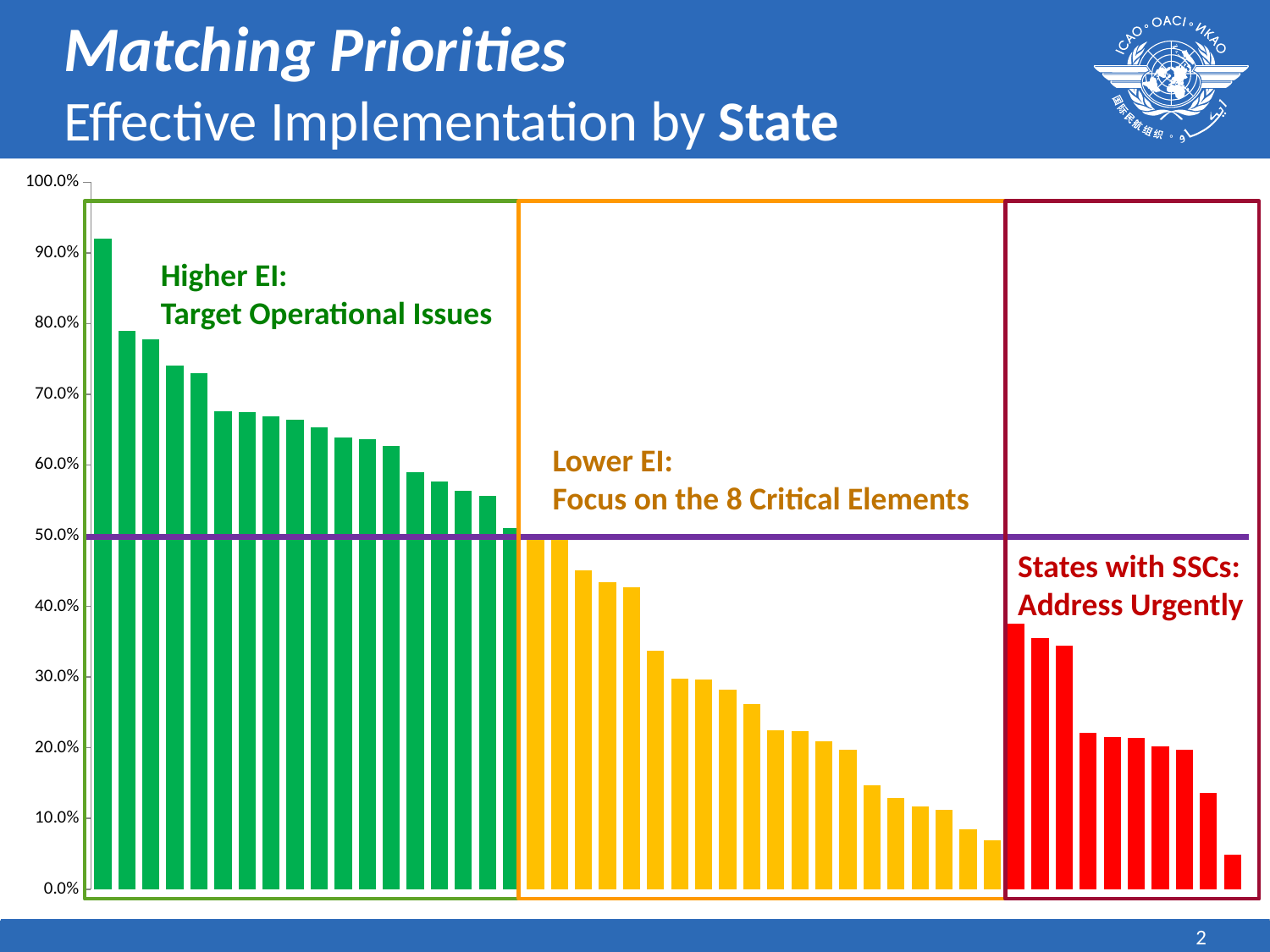
What type of chart is shown on the slide? bar chart Is the value of the leftmost (tallest) bar greater or less than 80%? greater What value on the y-axis does the horizontal purple line mark? 50.0% What label is written in the green section of the chart? Higher EI: Target Operational Issues Is the value of the rightmost bar greater or less than 10%? less Is the tallest red bar taller or shorter than the tallest yellow bar? shorter Is the value of the tallest red bar greater or less than 40%? less Which colour group contains the shortest bar in the chart? red Into how many colour-coded groups are the bars divided? 3 Which colour group contains the tallest bar in the chart? green